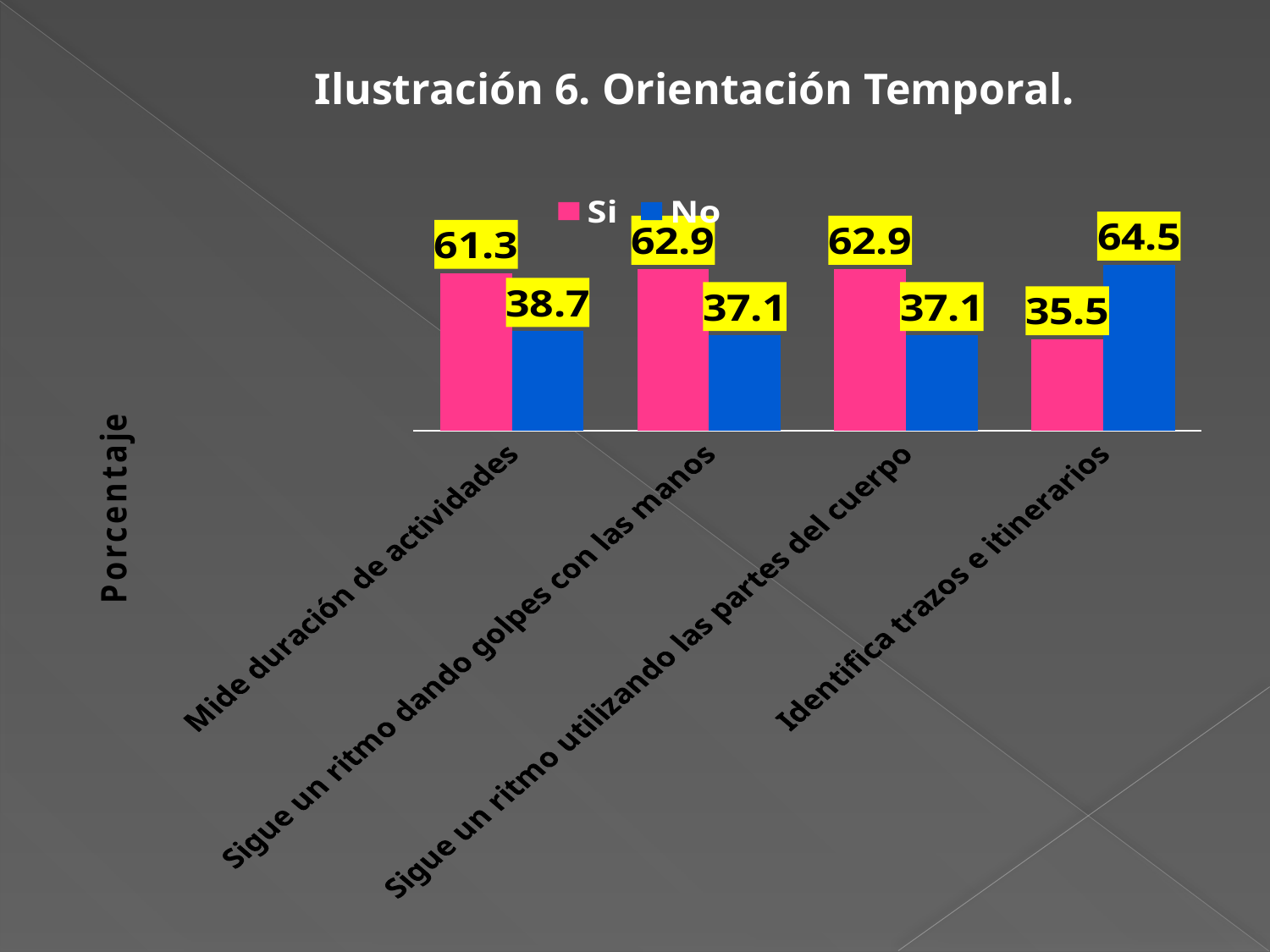
What is the 'Si' value for 'Identifica trazos e itinerarios'? 35.5 What is the 'No' value for 'Identifica trazos e itinerarios'? 64.5 How many series does the legend list? 2 What is the title of the chart? Ilustración 6. Orientación Temporal. What is the difference between the 'Si' and 'No' values for 'Mide duración de actividades'? 22.6 What is the 'Si' value for 'Mide duración de actividades'? 61.3 Which category has the lowest 'Si' value? Identifica trazos e itinerarios What kind of chart is shown on the slide? Bar chart For 'Identifica trazos e itinerarios', which is larger, the 'Si' value or the 'No' value? No Which category has the highest 'No' value? Identifica trazos e itinerarios What is the 'No' value for 'Sigue un ritmo dando golpes con las manos'? 37.1 How many categories are shown on the x axis? 4